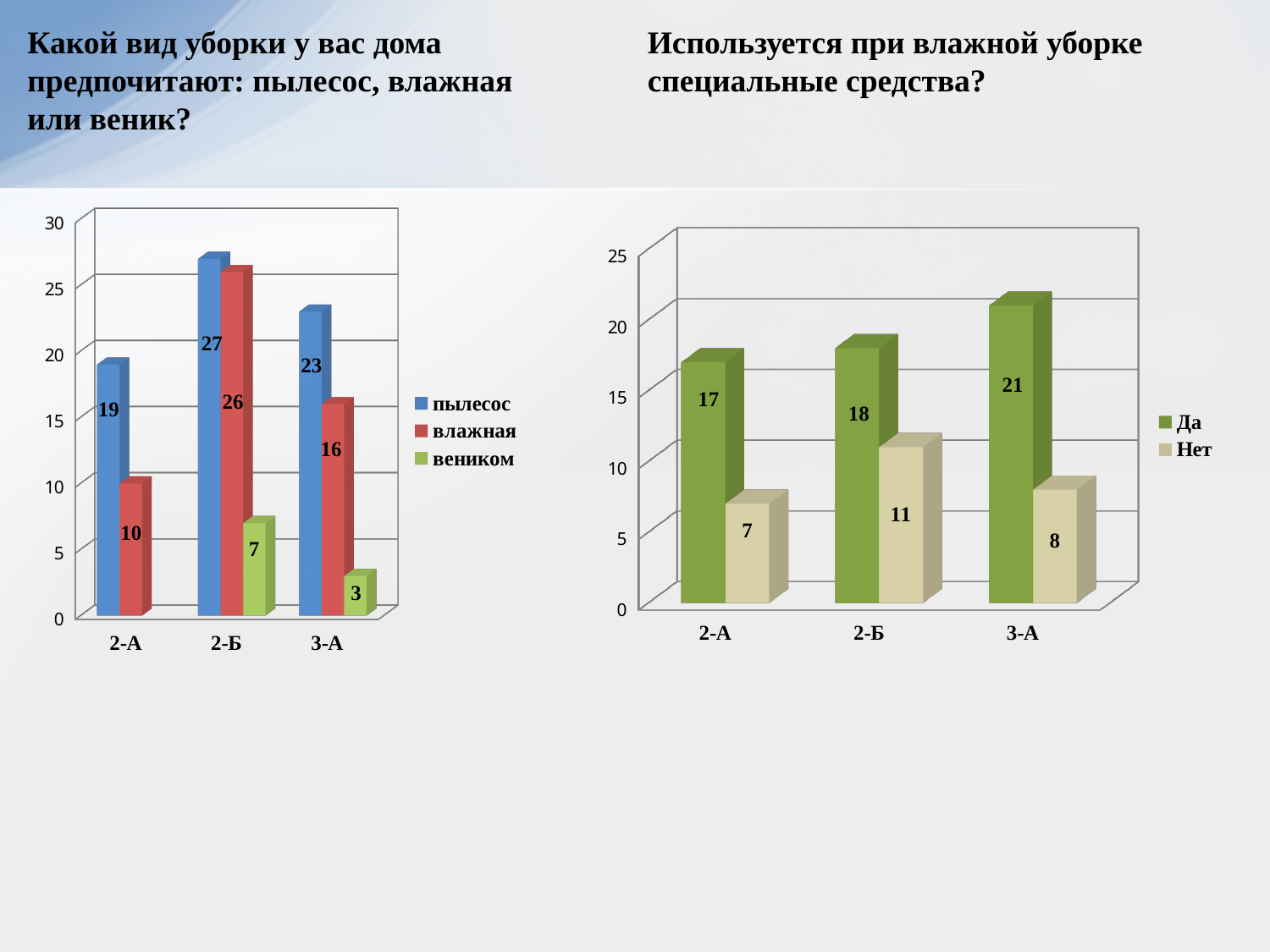
In the left chart, what is the value for пылесос in 2-Б? 27 In the left chart, which class has the highest value for пылесос? 2-Б What kind of chart is the right chart? bar chart How many categories are shown on the x axis of the right chart? 3 In the right chart, is the value for Да in 2-А larger than the value for Нет in 2-А? Yes In the right chart, which class has the highest value for Да? 3-А In the left chart, what is the difference between пылесос and влажная in 2-А? 9 In the left chart, what is the value for влажная in 3-А? 16 How many series does the legend of the left chart list? 3 In the right chart, what is the value for Нет in 2-Б? 11 In the left chart, which class has the lowest value for веником? 3-А In the right chart, what is the difference between Да and Нет in 3-А? 13